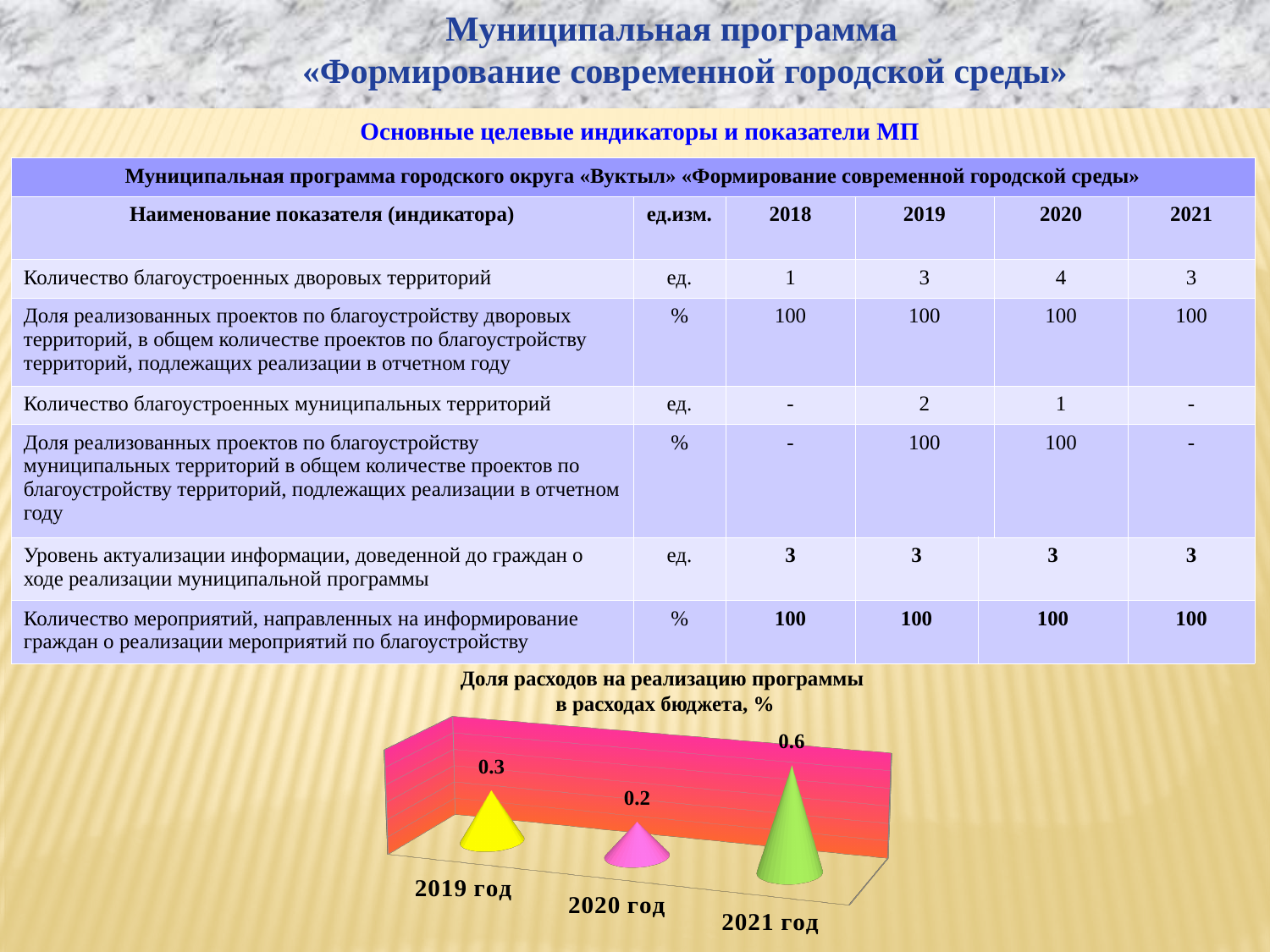
What is the value for 2021 год in the chart? 0.6 Which year has the lowest value in the chart? 2020 год How many years are shown in the chart? 3 Which year has the highest value in the chart? 2021 год Which is larger, the value for 2019 год or the value for 2021 год? 2021 год Does the value rise or fall from 2020 год to 2021 год? rise What is the difference between the values for 2019 год and 2020 год? 0.1 What is the difference between the values for 2021 год and 2020 год? 0.4 What is the value for 2020 год in the chart? 0.2 What is the title of the chart at the bottom of the slide? Доля расходов на реализацию программы в расходах бюджета, % What is the value for 2019 год in the chart 'Доля расходов на реализацию программы в расходах бюджета, %'? 0.3 What kind of chart is shown at the bottom of the slide? bar chart